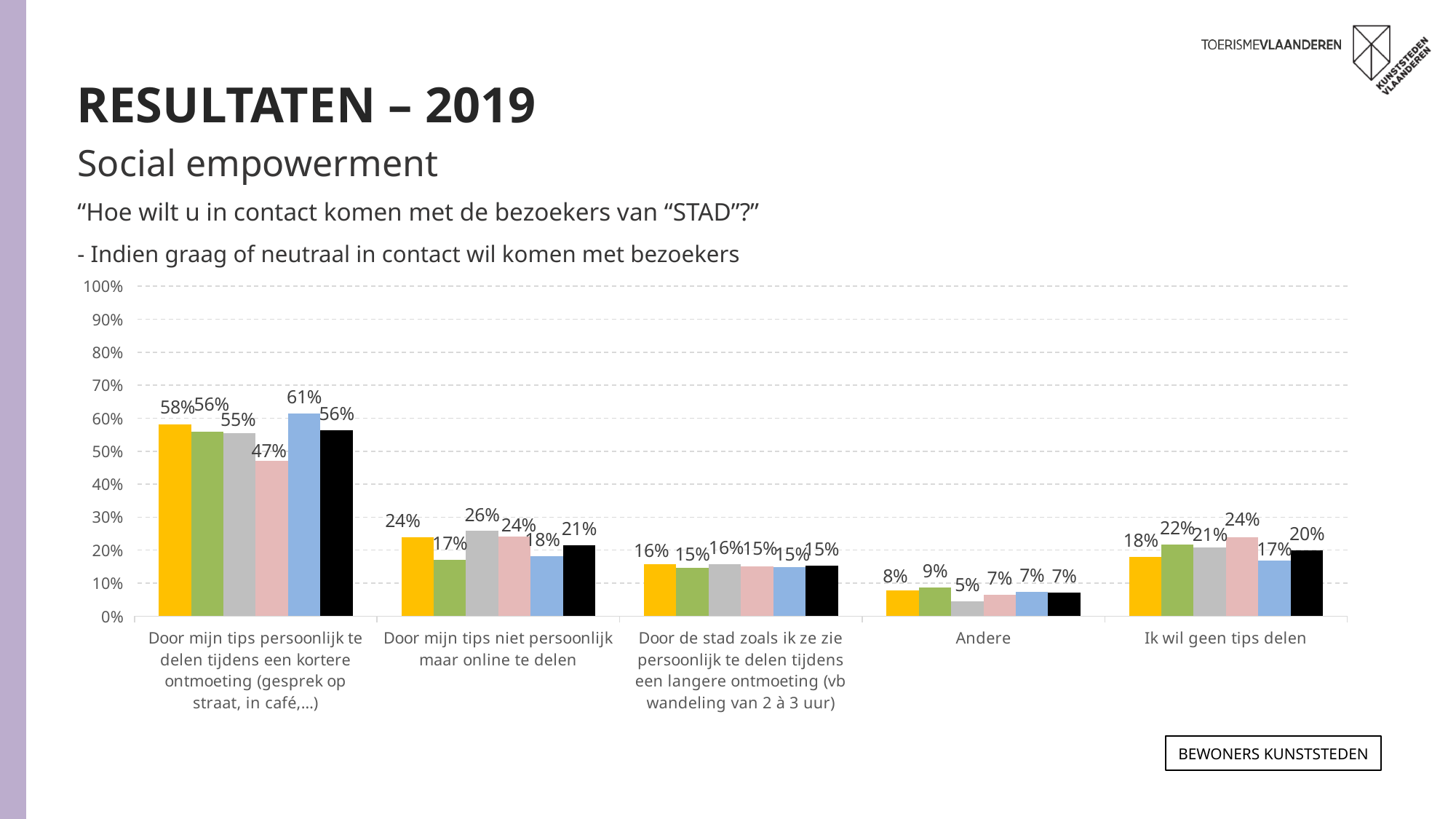
Which category has the highest values across all bars? Door mijn tips persoonlijk te delen tijdens een kortere ontmoeting (gesprek op straat, in café,...) What is the value of the grey bar for "Andere"? 5% What is the value of the pink bar for "Door mijn tips persoonlijk te delen tijdens een kortere ontmoeting (gesprek op straat, in café,...)"? 47% What is the value of the grey bar for "Door mijn tips niet persoonlijk maar online te delen"? 26% What is the value of the pink bar for "Ik wil geen tips delen"? 24% How many categories are shown along the x axis of the chart? 5 Which category has the lowest values across all bars? Andere What kind of chart is shown on the slide? bar chart What is the difference between the blue bar and the pink bar for "Door mijn tips persoonlijk te delen tijdens een kortere ontmoeting (gesprek op straat, in café,...)"? 14% How many bars are shown for each category in the chart? 6 Which is larger for "Door mijn tips niet persoonlijk maar online te delen": the yellow bar or the green bar? the yellow bar What is the value of the blue bar for "Door mijn tips persoonlijk te delen tijdens een kortere ontmoeting (gesprek op straat, in café,...)"? 61%